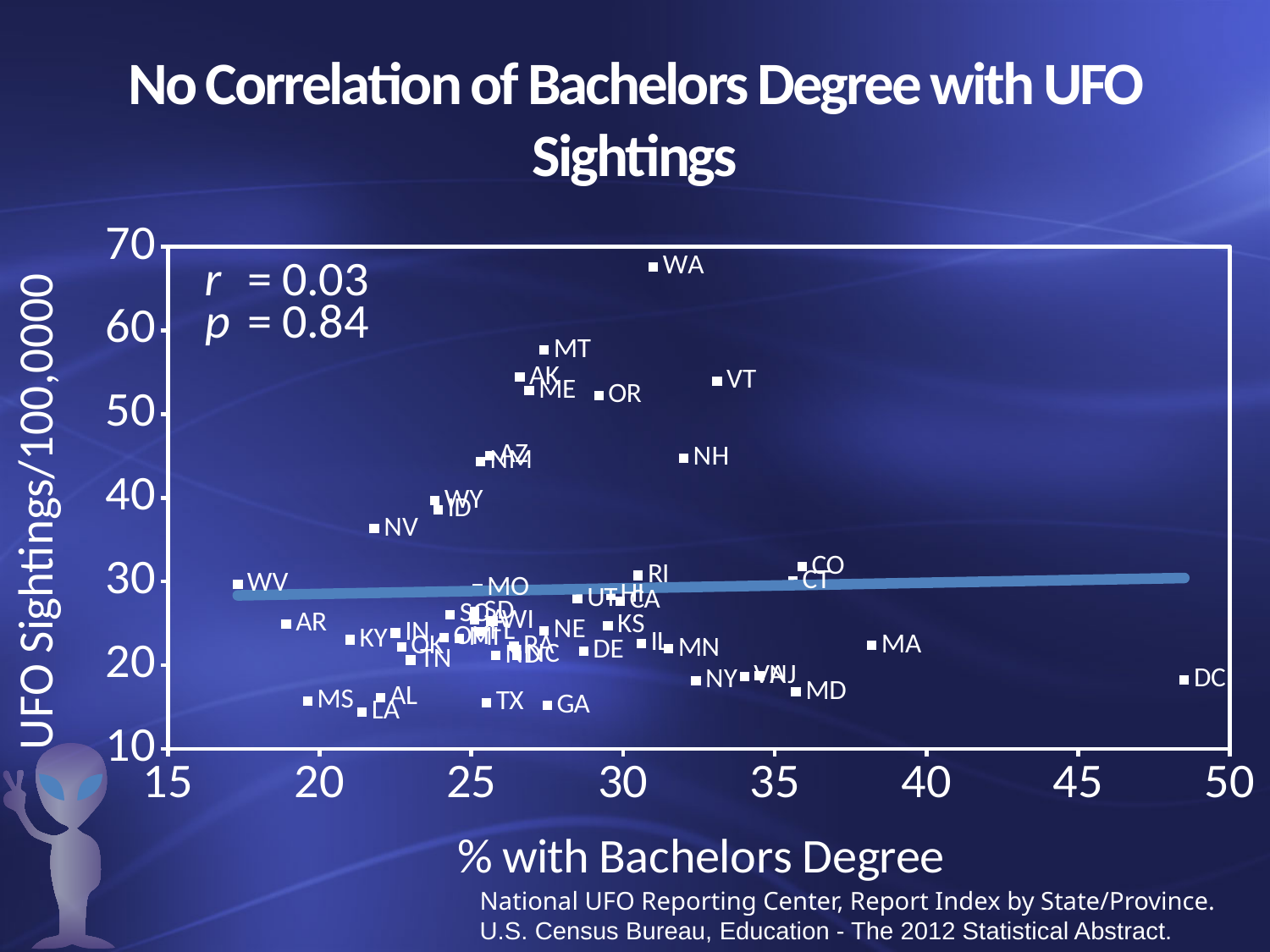
Which point has the highest % with Bachelors Degree on the chart? DC What is the p value shown on the chart? 0.84 Is the UFO sightings value for NV greater or less than 40? less Is the % with Bachelors Degree for DC greater or less than 45? greater Is the UFO sightings value for WA greater or less than 60? greater Which state has the lowest % with Bachelors Degree on the chart? WV What is the correlation coefficient r shown on the chart? 0.03 What kind of chart is shown on the slide? scatter plot Which has more UFO sightings per 100,000, WA or VT? WA Which state has the highest UFO sightings per 100,000 on the chart? WA